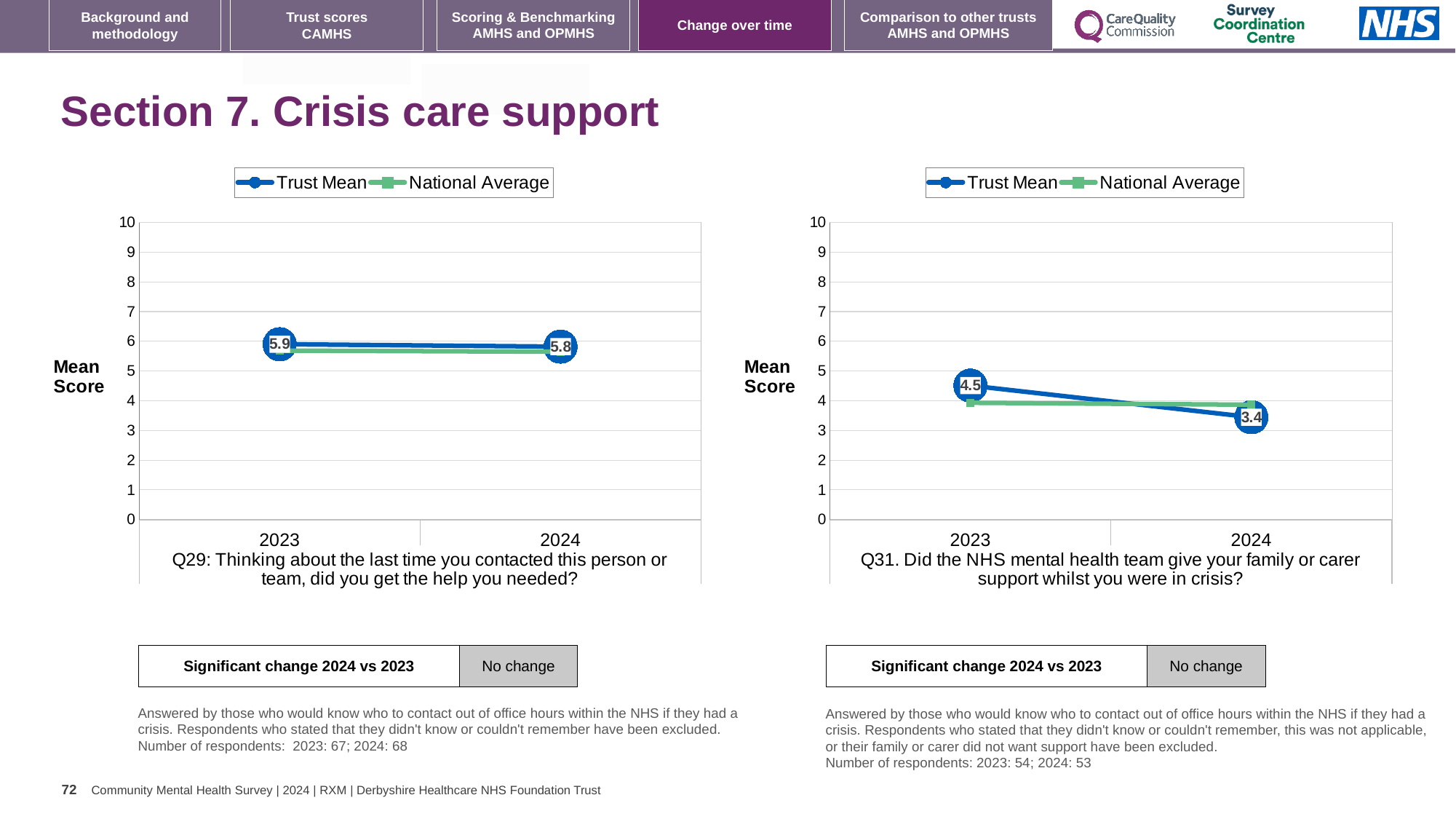
How many series does the legend of the Q29 chart on the left list? 2 In the Q31 chart on the right, is the National Average for 2024 greater or less than 3? greater In the Q31 chart on the right, what is the Trust Mean score for 2024? 3.4 In the Q31 chart on the right, does the Trust Mean rise or fall from 2023 to 2024? fall In the Q31 chart on the right, by how much did the Trust Mean fall from 2023 to 2024? 1.1 In the Q29 chart on the left, what is the Trust Mean score for 2023? 5.9 In the Q31 chart on the right, what is the Trust Mean score for 2023? 4.5 In the Q31 chart on the right, is the Trust Mean for 2023 higher or lower than the National Average for 2023? higher In the Q29 chart on the left, what is the Trust Mean score for 2024? 5.8 What type of chart is used for Q29 on the left? line chart How many years are plotted on the x axis of the Q31 chart on the right? 2 In the Q29 chart on the left, what is the difference between the Trust Mean in 2023 and in 2024? 0.1